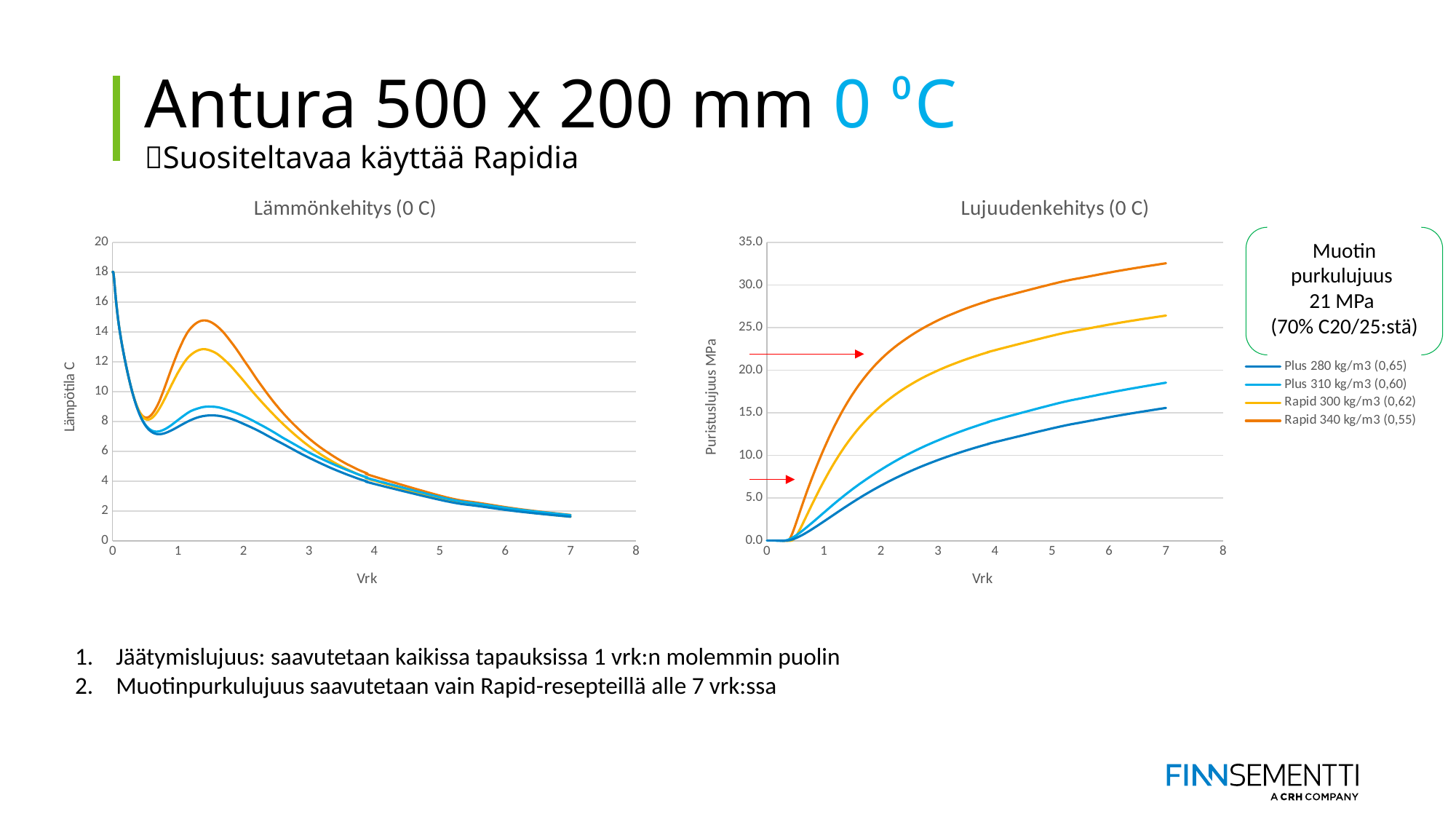
In the "Lämmönkehitys (0 C)" chart, is the peak temperature of the highest curve greater or less than 14? greater In the "Lujuudenkehitys (0 C)" chart, is the value for Plus 310 kg/m3 (0,60) at day 7 greater or less than 20.0? less In the "Lujuudenkehitys (0 C)" chart, do the strength values rise or fall as the days increase? rise In the "Lujuudenkehitys (0 C)" chart, which series has the lowest strength at day 7? Plus 280 kg/m3 (0,65) In the "Lujuudenkehitys (0 C)" chart, which series reaches the highest strength at day 7? Rapid 340 kg/m3 (0,55) What is the y-axis label of the "Lujuudenkehitys (0 C)" chart? Puristuslujuus MPa What kind of chart is the "Lämmönkehitys (0 C)" chart on the left? line chart How many series does the legend of the "Lujuudenkehitys (0 C)" chart list? 4 What kind of chart is the "Lujuudenkehitys (0 C)" chart on the right? line chart In the "Lujuudenkehitys (0 C)" chart, is the value for Rapid 340 kg/m3 (0,55) at day 7 greater or less than 30.0? greater In the "Lämmönkehitys (0 C)" chart, do the temperature values rise or fall between day 3 and day 7? fall